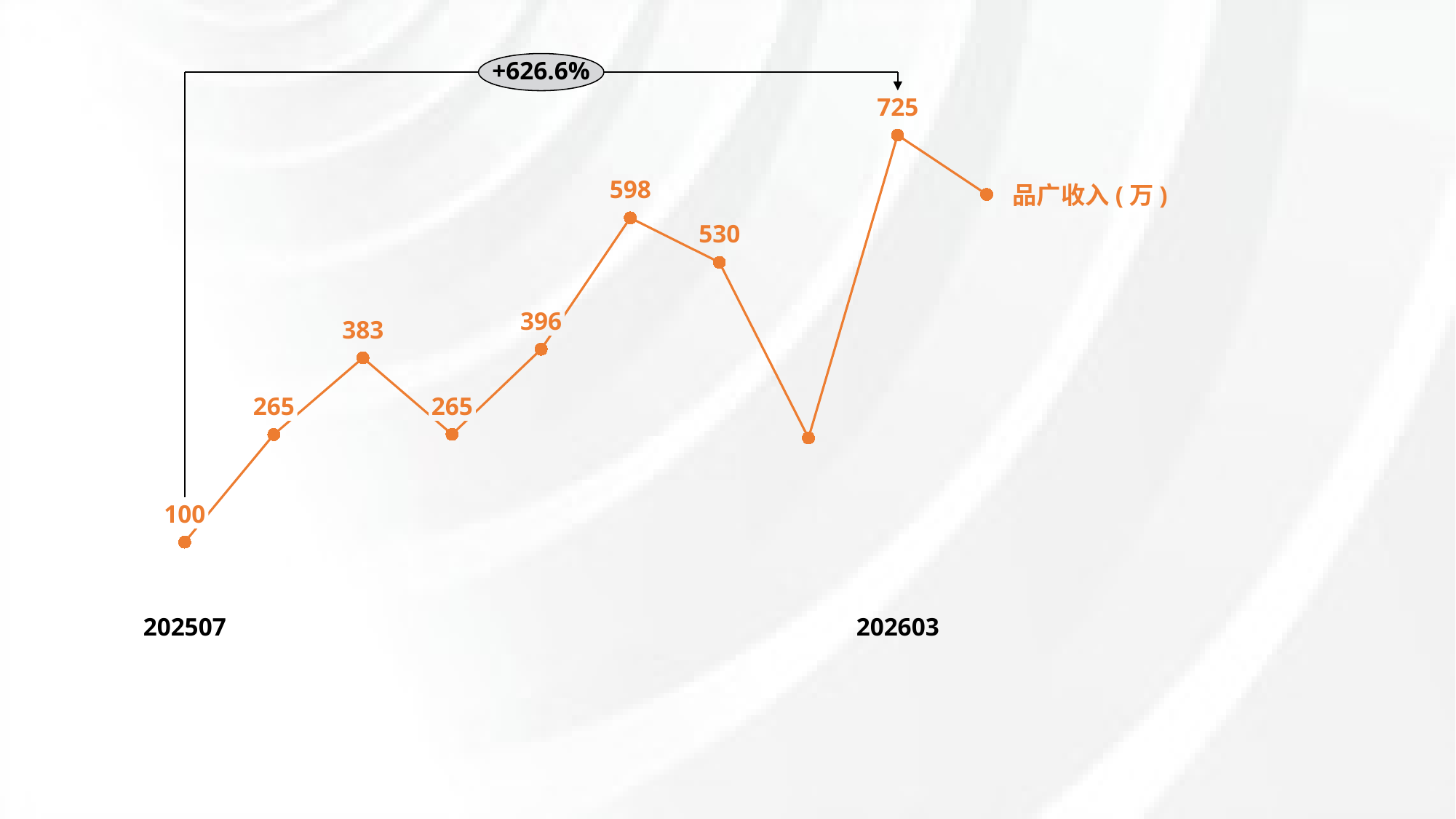
Which is larger, the value at 202507 or the value at 202603? 202603 What kind of chart is shown on the slide? line chart Which labeled period has the lowest value on the chart? 202507 What is the difference between the data point labeled 598 and the following data point labeled 530? 68 What is the value of 品广收入（万） at 202507? 100 What is the value of 品广收入（万） at 202603? 725 What is the value of the second data point on the line (immediately after 202507)? 265 Which labeled period has the highest value on the chart? 202603 What percentage change is shown in the annotation between 202507 and 202603? +626.6% What is the value of the third data point on the line? 383 How many data points are plotted on the line? 10 What is the difference between the value at 202603 and the value at 202507? 625